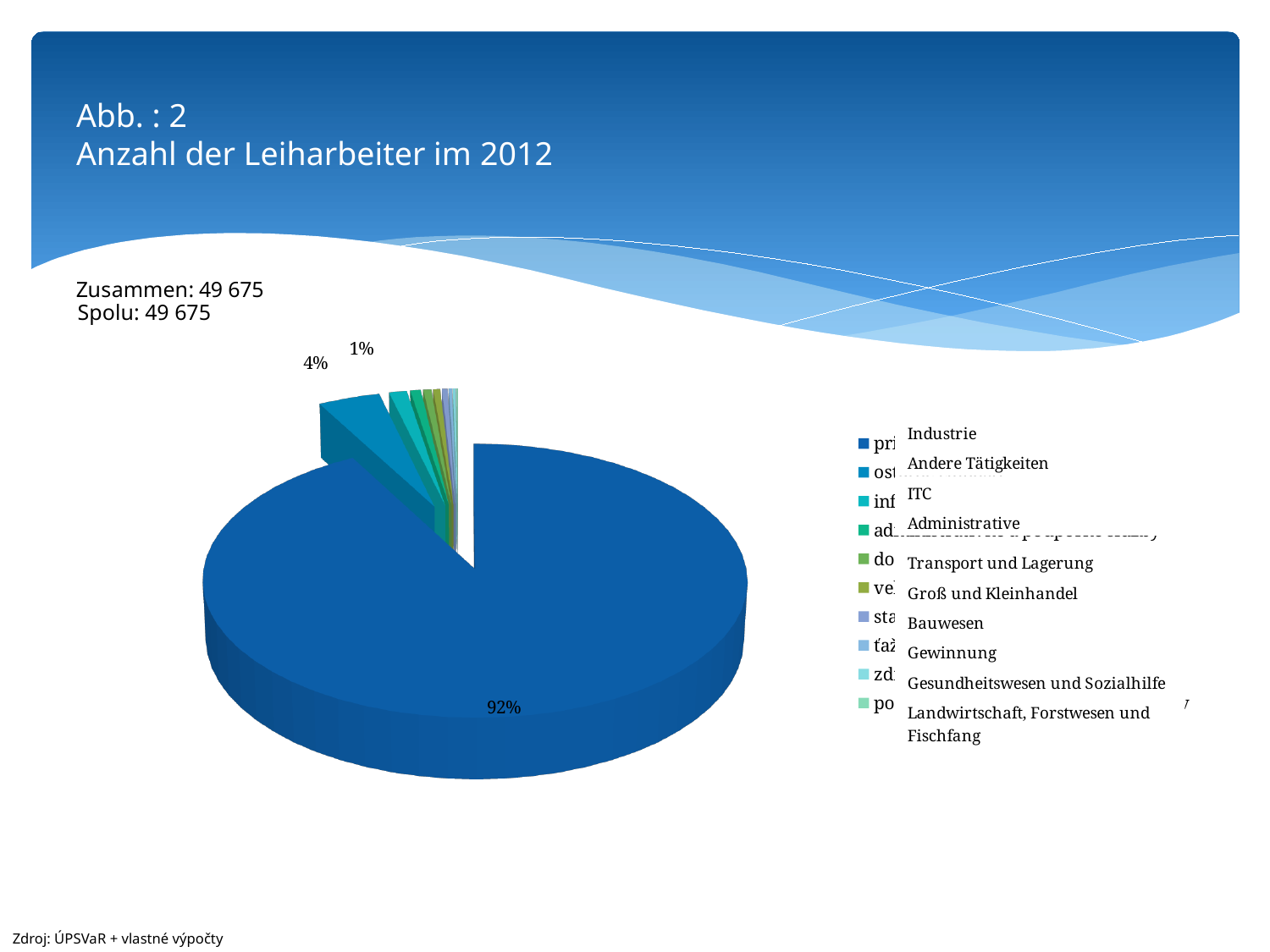
Which category has the largest slice of the pie? Industrie Is the share of the Industrie slice greater or less than 50%? greater What kind of chart is shown on the slide? pie chart What is the total number of Leiharbeiter stated on the slide (Zusammen)? 49 675 What share of the pie does the Industrie slice represent? 92% What share of the pie does the Andere Tätigkeiten slice represent? 4% How many categories does the legend list? 10 Which category is listed last in the legend? Landwirtschaft, Forstwesen und Fischfang Which is larger, the Industrie slice or the Andere Tätigkeiten slice? Industrie How many percentage points larger is the Industrie share than the Andere Tätigkeiten share? 88 What is the title of the chart on the slide? Anzahl der Leiharbeiter im 2012